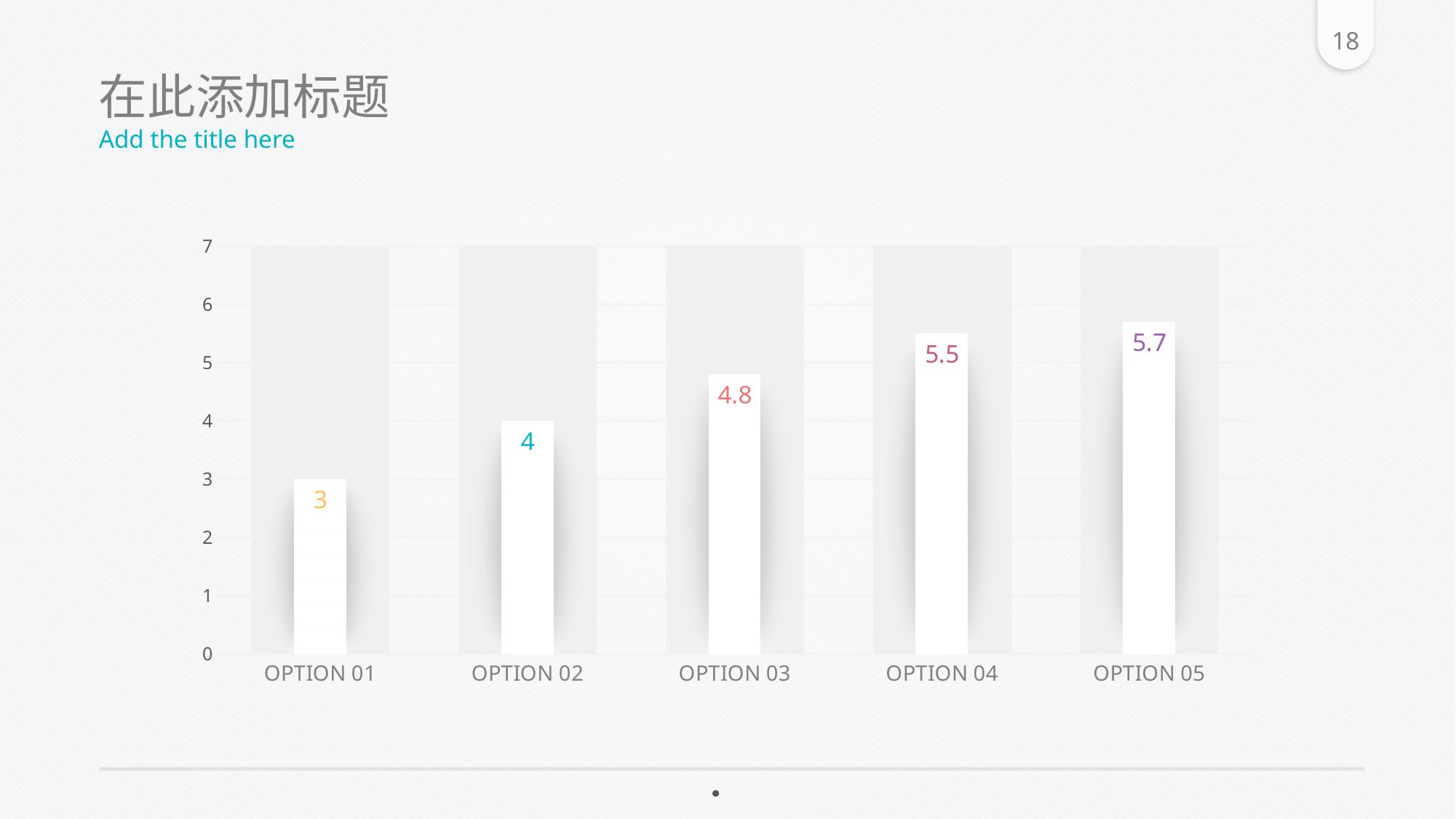
What is the value for OPTION 05? 5.7 How many categories are shown on the x axis? 5 Do the values rise or fall from OPTION 01 to OPTION 05? rise What is the highest value shown on the vertical axis? 7 What kind of chart is shown on the slide? bar chart Which category has the lowest value? OPTION 01 Which is larger, the value for OPTION 02 or the value for OPTION 03? OPTION 03 What is the value for OPTION 03? 4.8 Is the value for OPTION 04 greater or less than 5? greater What is the difference between the values for OPTION 04 and OPTION 02? 1.5 What is the value for OPTION 01? 3 Which category has the highest value? OPTION 05